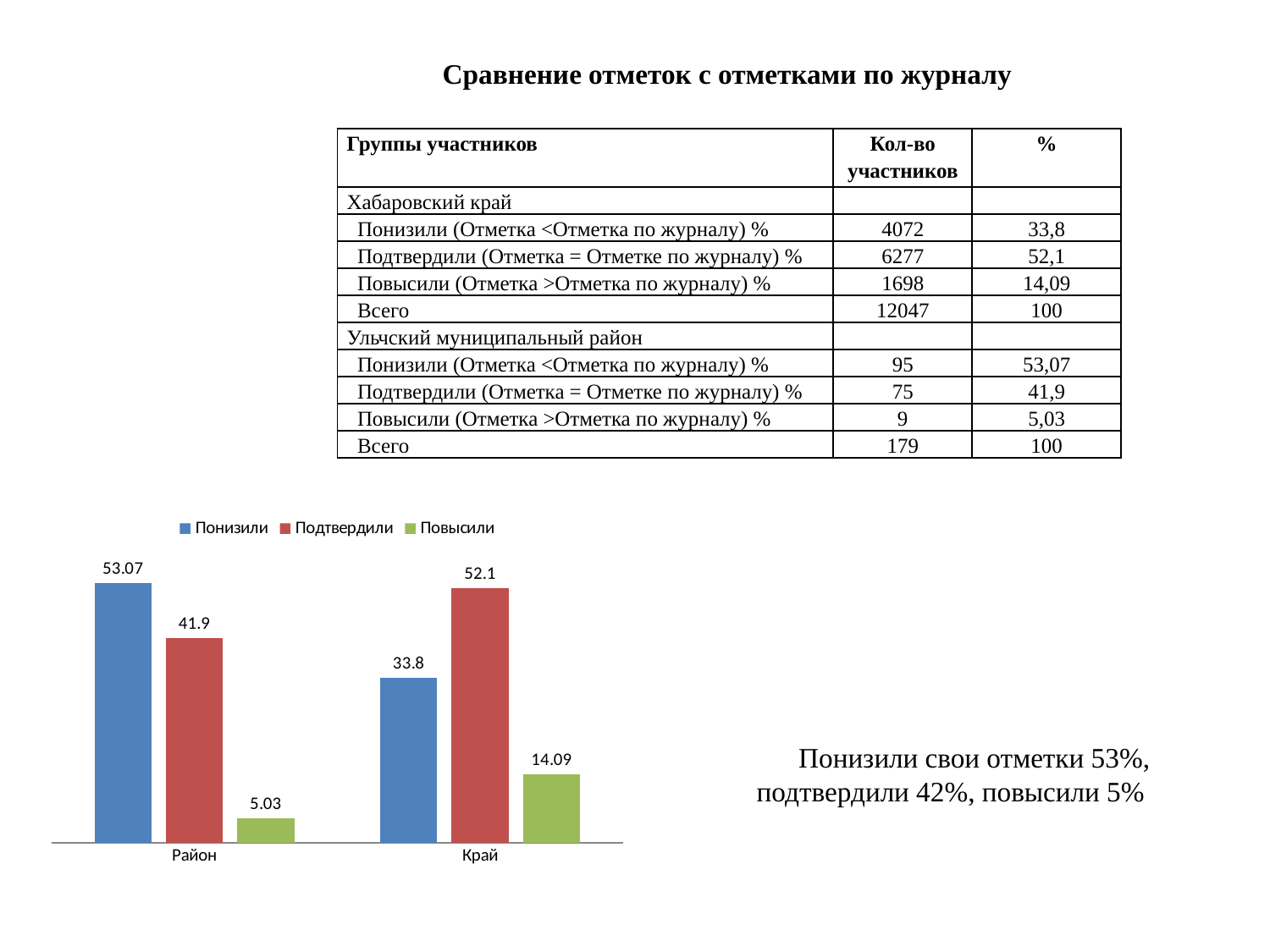
Which is larger: the Подтвердили value for Район or the Подтвердили value for Край? Край What is the value of the Повысили bar for Район? 5.03 What type of chart is shown on the slide? Bar chart How many series does the chart legend list? 3 What is the value of the Понизили bar for Район? 53.07 What is the value of the Повысили bar for Край? 14.09 What is the value of the Подтвердили bar for Край? 52.1 Which series has the highest value for Край? Подтвердили How many categories are shown on the x axis of the chart? 2 What is the difference between the Понизили values for Район and Край? 19.27 What is the difference between the Подтвердили and Повысили values for Край? 38.01 Which series has the lowest value for Район? Повысили